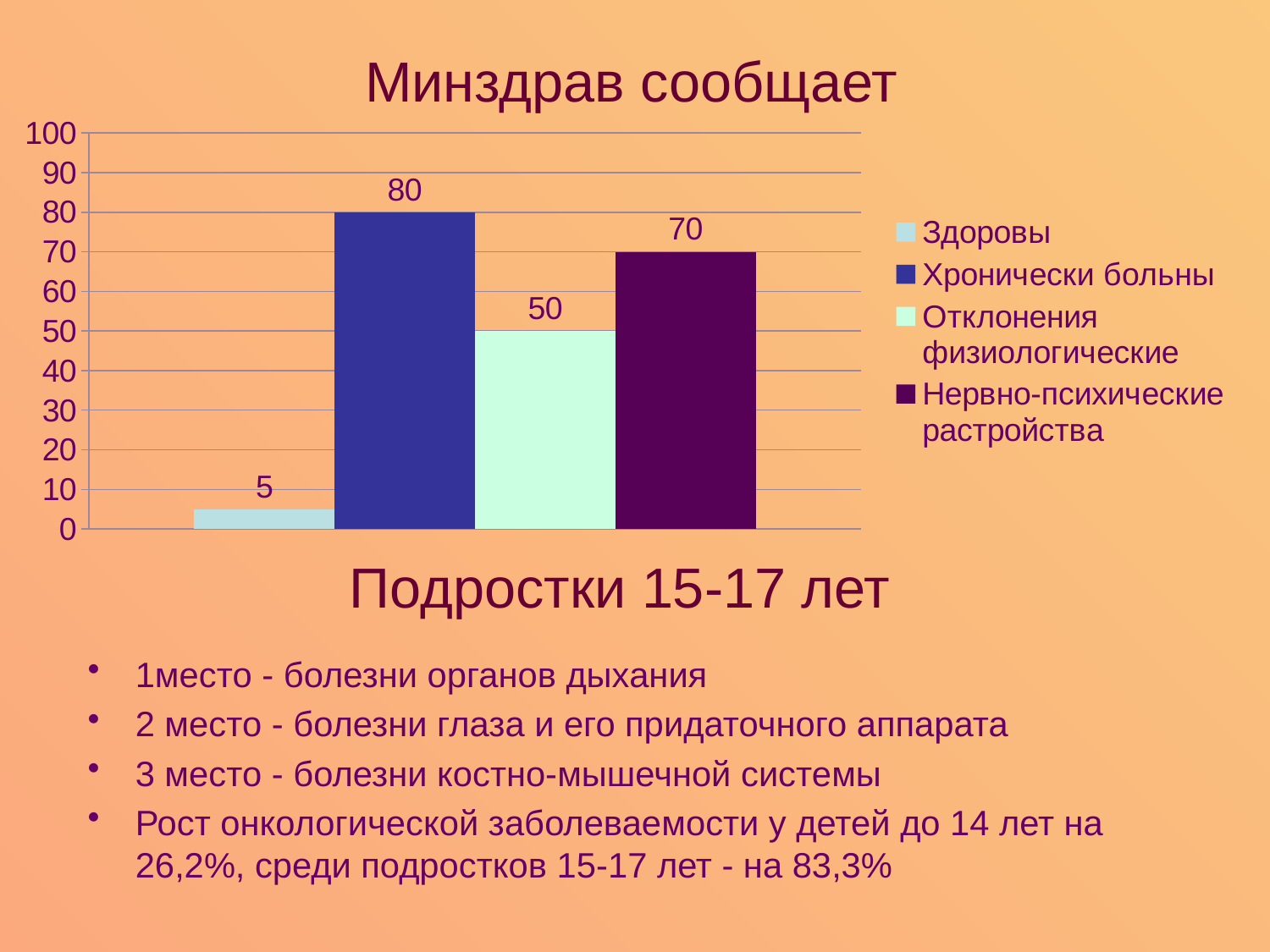
What kind of chart is shown on the slide? bar chart Is the value for Отклонения физиологические greater or less than 60? less What is the value for Нервно-психические расстройства? 70 Which series has the lowest value? Здоровы Which is larger, the value for Отклонения физиологические or the value for Нервно-психические расстройства? Нервно-психические расстройства What is the value for Хронически больны? 80 What is the value for Отклонения физиологические? 50 What is the difference between the values for Хронически больны and Нервно-психические расстройства? 10 Which series has the highest value? Хронически больны What is the value for Здоровы? 5 How many series does the legend list? 4 What is the title of the chart? Минздрав сообщает